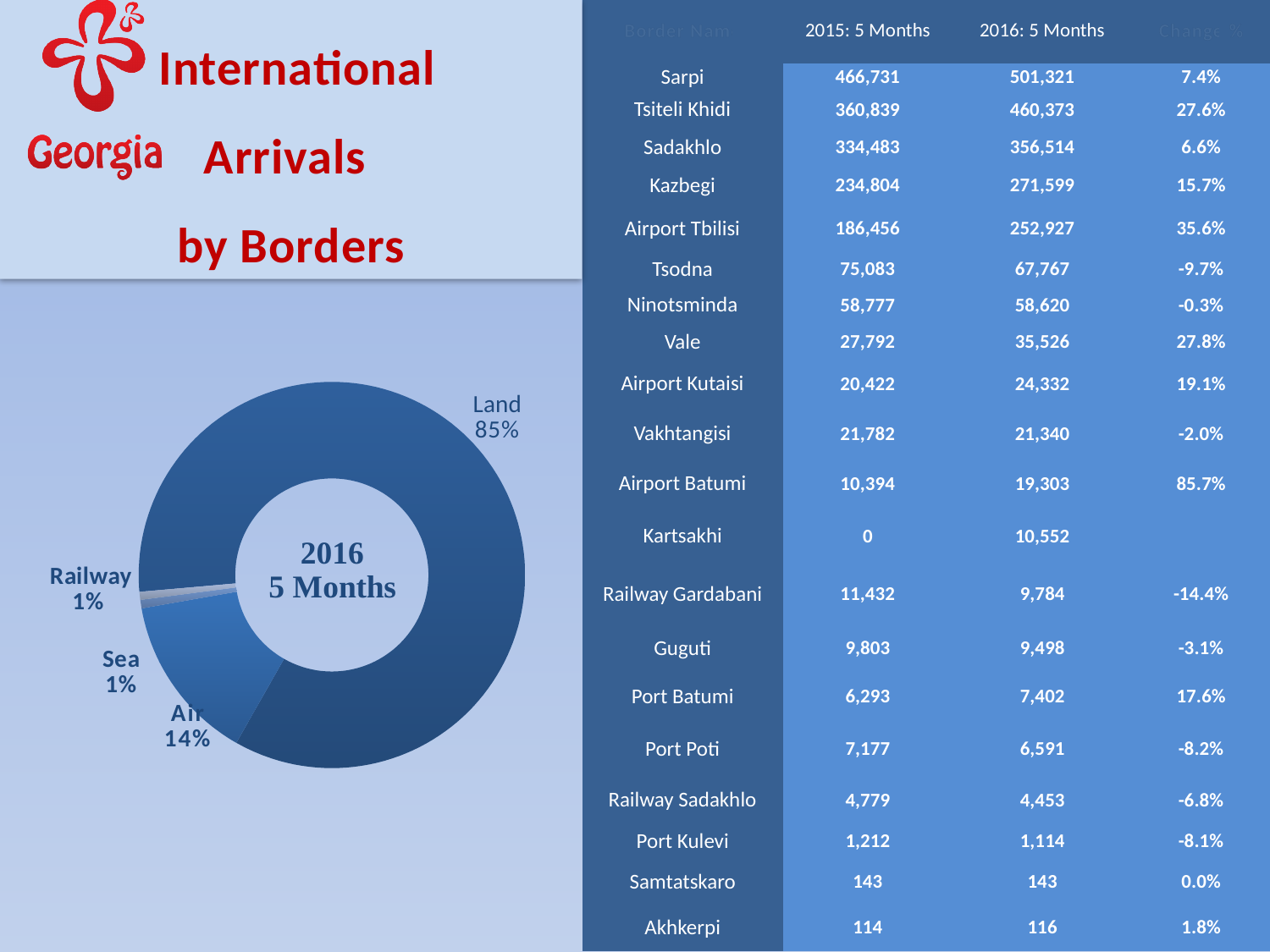
Is the Land share in the donut chart greater or less than 50%? greater What is the difference in percentage points between the Land and Air slices in the donut chart? 71% What share of arrivals does the Sea slice represent in the donut chart? 1% Which category has the largest slice in the donut chart? Land How many slices does the donut chart have? 4 What period is labelled in the centre of the donut chart? 2016 5 Months What kind of chart is shown on the left of the slide? Donut (pie) chart What share of arrivals does the Air slice represent in the donut chart? 14% What share of arrivals does the Land slice represent in the donut chart? 85% In the donut chart, which is larger, the Air slice or the Sea slice? Air What is the combined share of the Sea and Railway slices in the donut chart? 2%